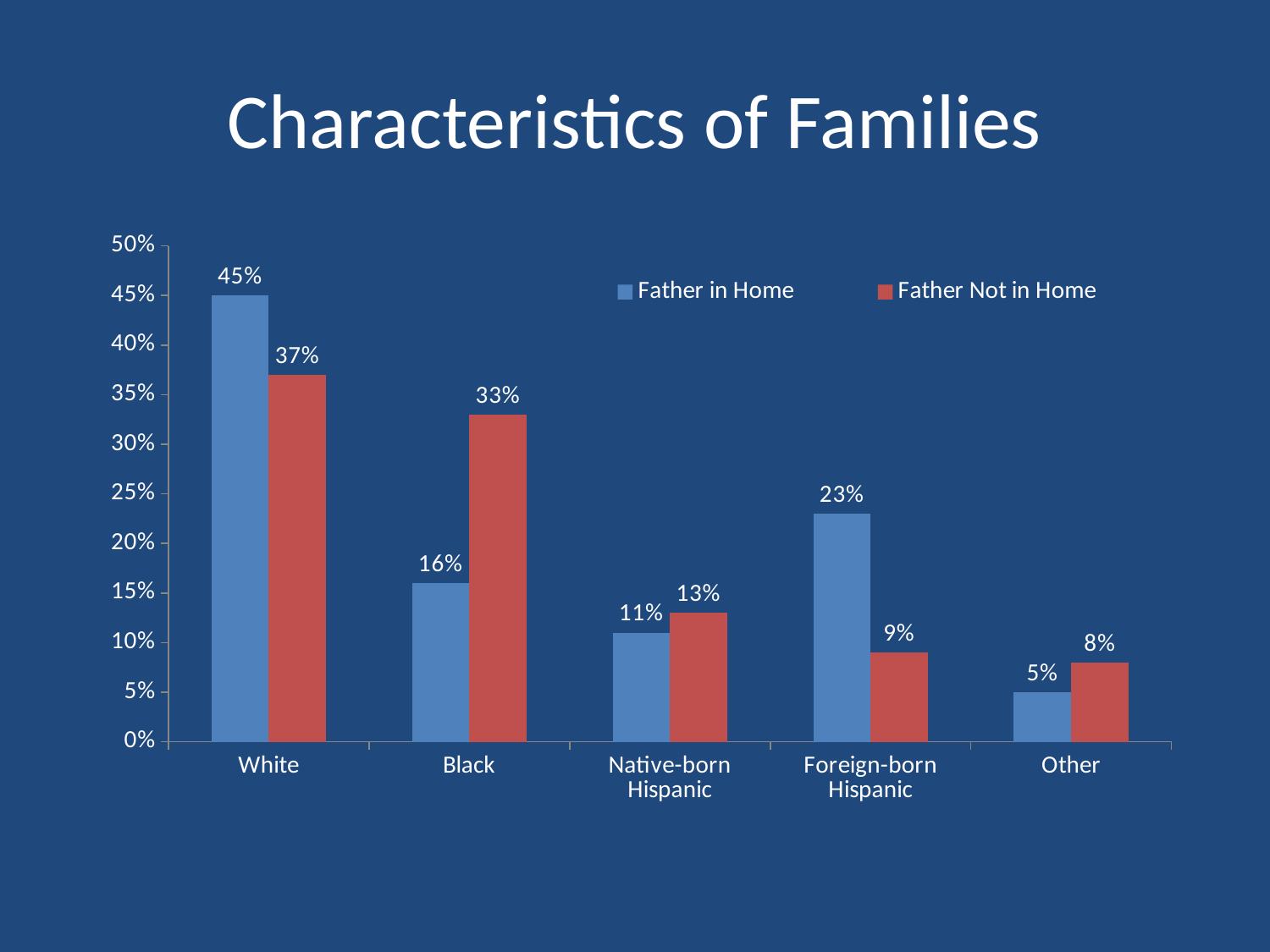
What is the value for Father in Home for Foreign-born Hispanic? 23% Which category has the lowest Father Not in Home value? Other Which category has the highest Father in Home value? White What is the difference between Father in Home and Father Not in Home for Black? 17% How many series does the legend list? 2 What kind of chart is shown on the slide? Bar chart What is the value for Father in Home for White? 45% What is the title of the slide? Characteristics of Families For Native-born Hispanic, which is larger: Father in Home or Father Not in Home? Father Not in Home How many categories are shown on the x axis? 5 What is the value for Father Not in Home for Other? 8% What is the value for Father Not in Home for Black? 33%